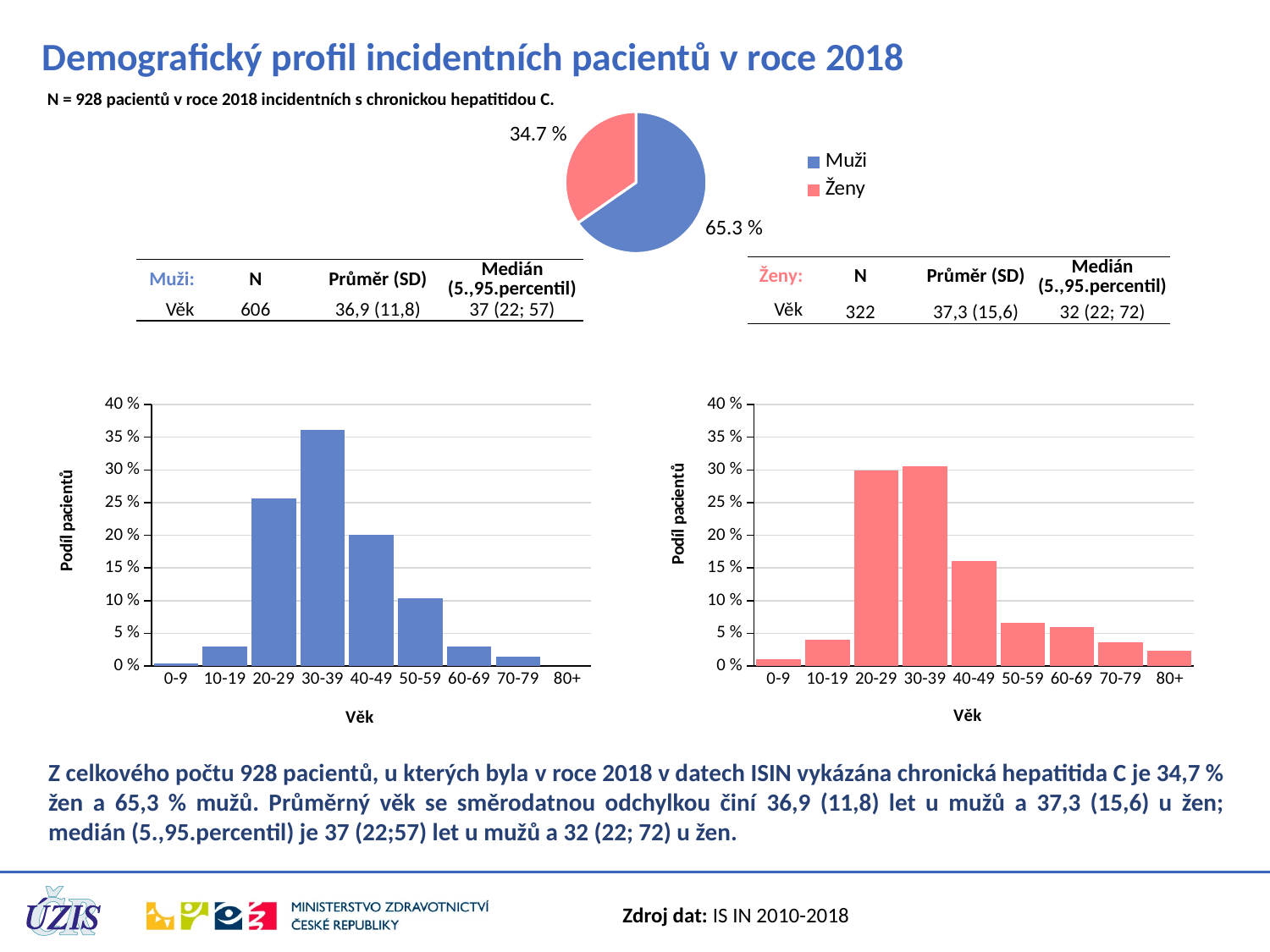
In the pie chart, what share is shown for Ženy? 34.7 % In the right (pink) bar chart, is the value for 40-49 greater or less than 20 %? less In the pie chart, which group has the larger slice, Muži or Ženy? Muži How many age groups are shown on the x axis of the left (blue) bar chart? 9 In the right (pink) bar chart, is the value for 20-29 greater or less than 25 %? greater In the right (pink) bar chart, which age group has the lowest share of patients? 0-9 How many entries does the legend of the pie chart list? 2 In the left (blue) bar chart, is the value for 30-39 greater or less than 35 %? greater In the pie chart, what share is shown for Muži? 65.3 % In the left (blue) bar chart, which age group has the highest share of patients? 30-39 What type of chart is the left chart showing Podíl pacientů by Věk? Bar chart